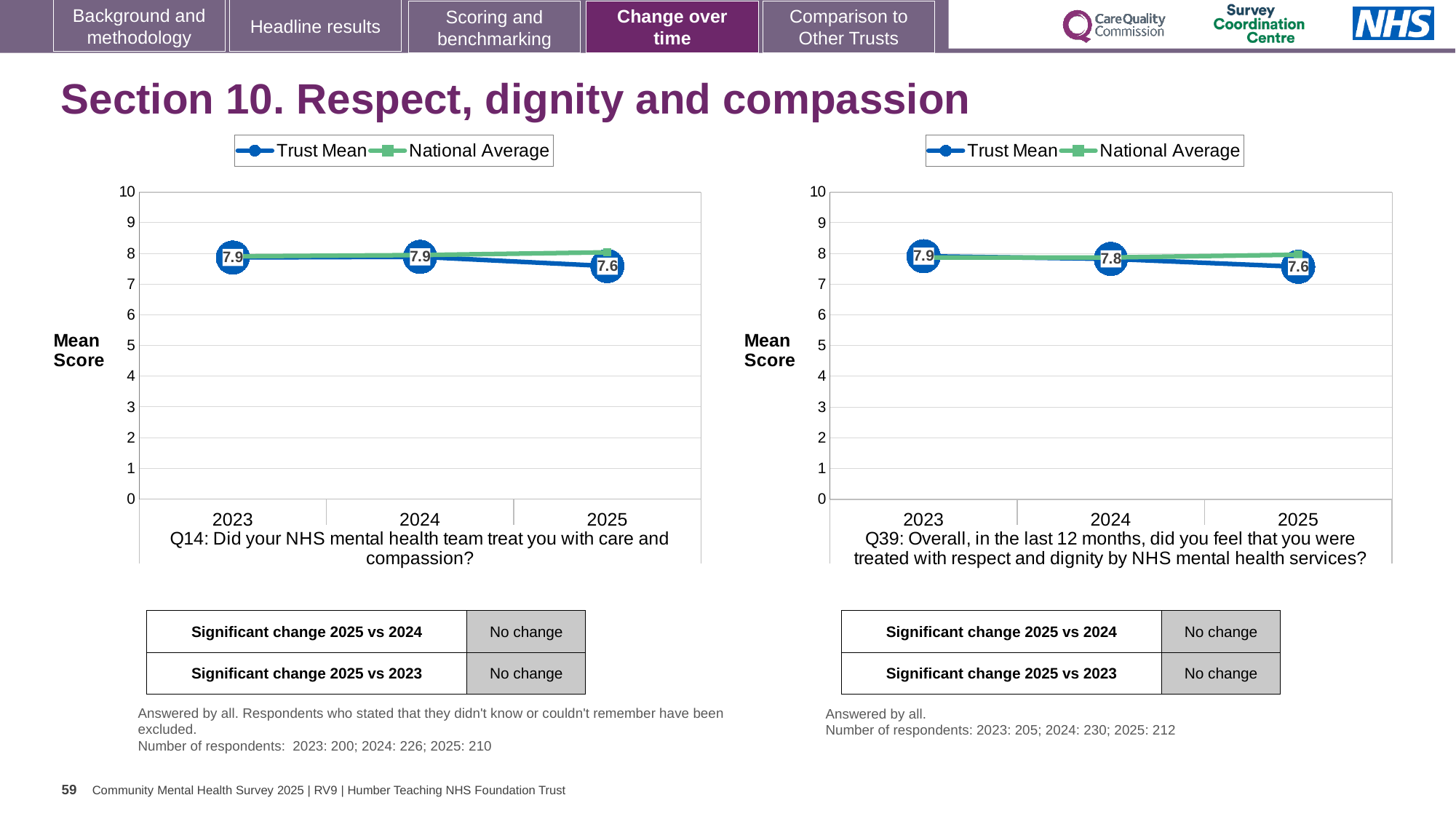
How many series does the legend of the left chart (Q14) list? 2 On the left chart (Q14), what is the Trust Mean for 2023? 7.9 On the right chart (Q39), is the Trust Mean for 2024 larger or smaller than the Trust Mean for 2025? larger On the right chart (Q39), what is the Trust Mean for 2024? 7.8 On the right chart (Q39), what is the Trust Mean for 2025? 7.6 What type of chart is the right chart (Q39)? line chart On the left chart (Q14), does the Trust Mean rise or fall from 2024 to 2025? fall On the right chart (Q39), in which year is the Trust Mean highest? 2023 On the left chart (Q14), what is the Trust Mean for 2025? 7.6 On the left chart (Q14), what is the difference between the Trust Mean in 2024 and in 2025? 0.3 On the right chart (Q39), what is the difference between the Trust Mean in 2023 and in 2025? 0.3 On the left chart (Q14), in which year is the Trust Mean lowest? 2025